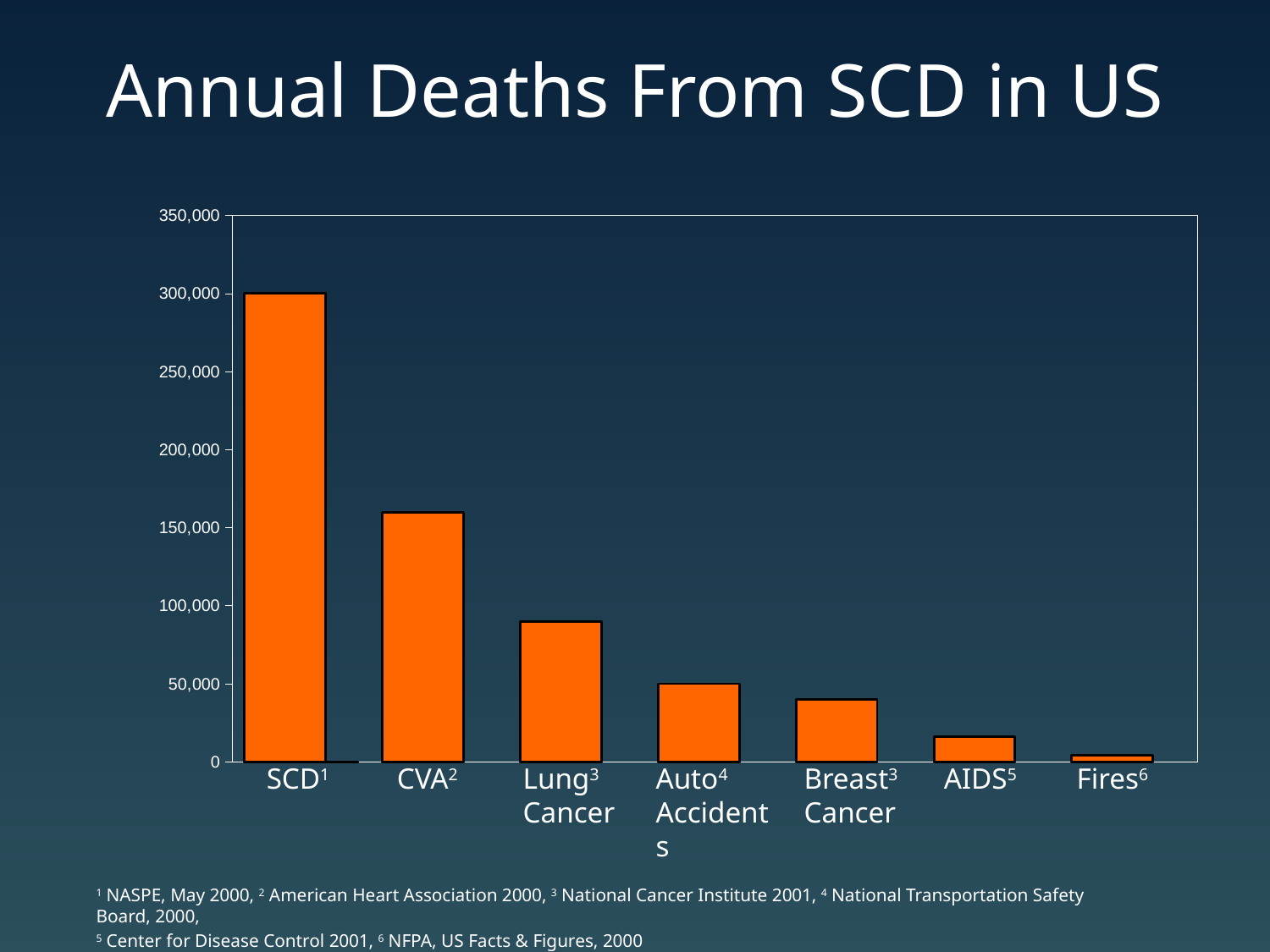
Is the value for Breast Cancer greater or less than 50,000? less Which category has the highest value? SCD What colour are the bars in the chart? orange What is the value for SCD? 300,000 What is the title of the chart? Annual Deaths From SCD in US What kind of chart is shown on the slide? bar chart Which is larger, the value for CVA or the value for Lung Cancer? CVA Which category has the lowest value? Fires Is the value for CVA greater or less than 150,000? greater How many categories are plotted on the chart? 7 Is the value for Lung Cancer greater or less than 100,000? less Do the values rise or fall moving from left to right along the x axis? fall